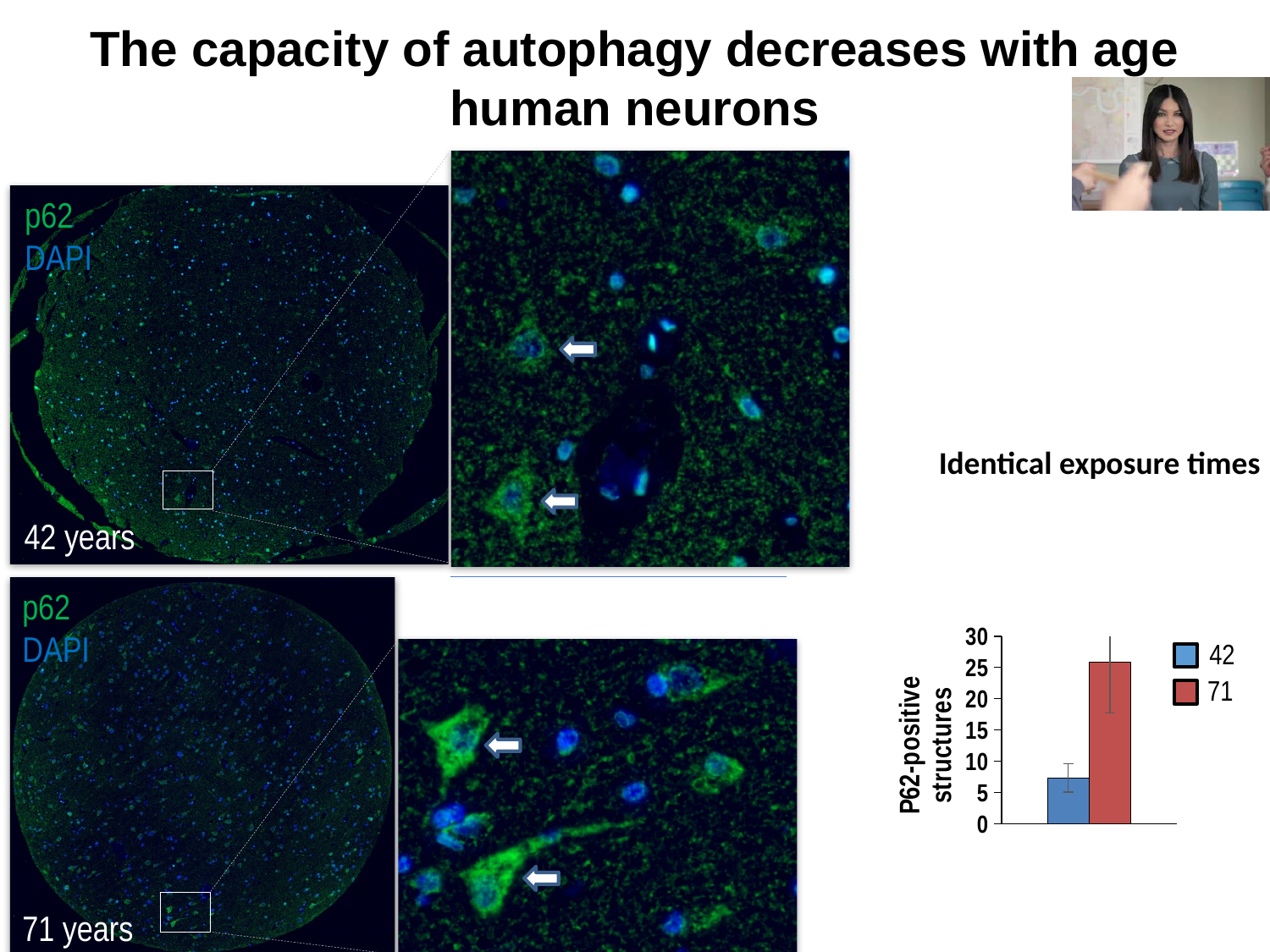
Is the bar for 71 larger or smaller than the bar for 42? larger Which series has the higher value of P62-positive structures, 42 or 71? 71 What is the label of the chart's vertical axis? P62-positive structures Which series has the lower value of P62-positive structures? 42 How many bars are plotted in the chart? 2 Is the value for 42 greater or less than 10? less What colour is the bar for the 71 series in the chart? red Is the value for 71 greater or less than 15? greater Is the value for 42 greater or less than 5? greater How many series does the chart's legend list? 2 What kind of chart is shown on the slide? bar chart